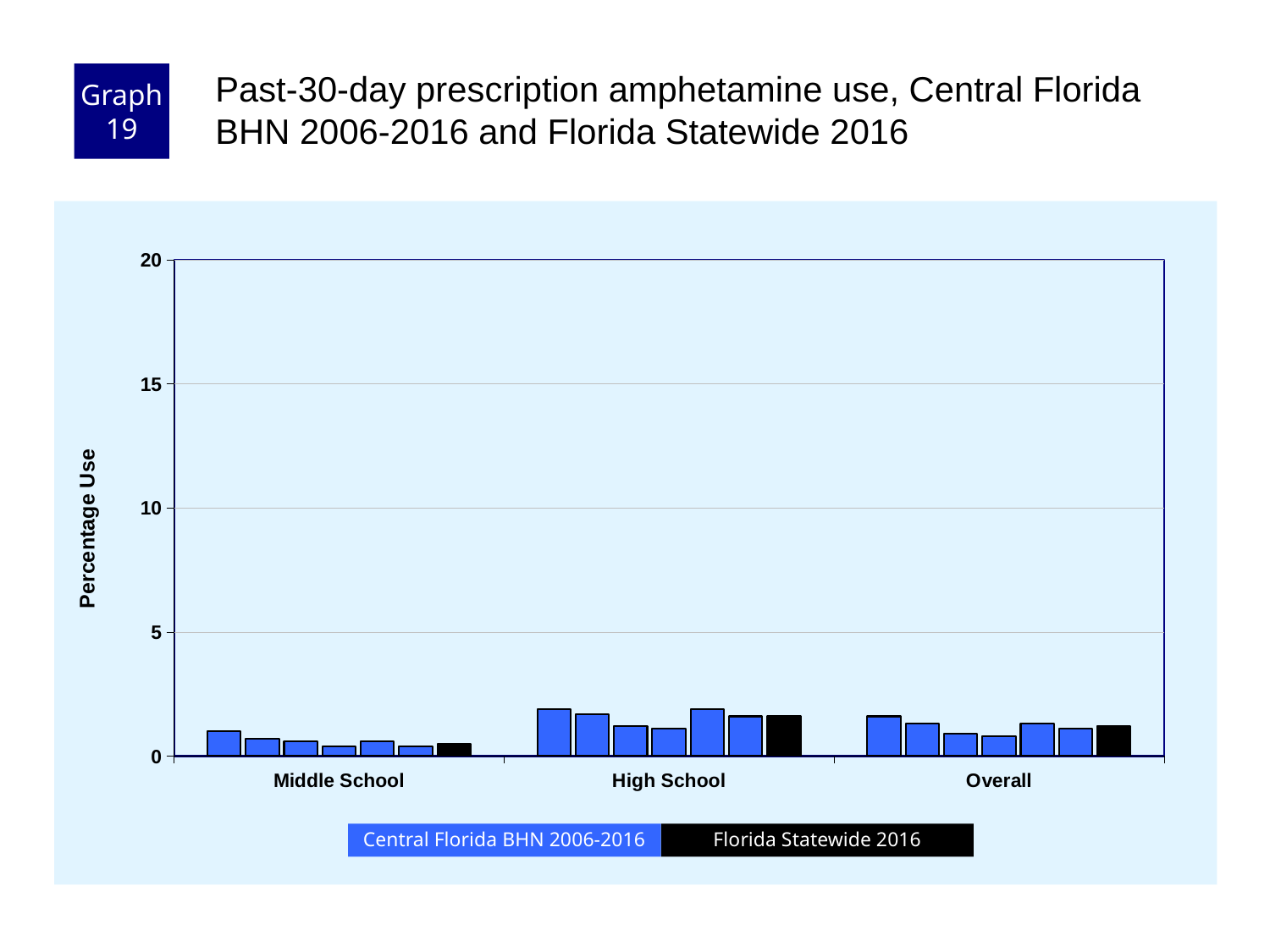
Is the Florida Statewide 2016 value larger for High School or for Middle School? High School Which category has the highest Florida Statewide 2016 value? High School How many categories are shown on the x axis of the chart? 3 Which series is shown in black in the chart? Florida Statewide 2016 Which category has the lowest Florida Statewide 2016 value? Middle School What is the label of the y axis? Percentage Use What kind of chart is shown on the slide? bar chart Is the Florida Statewide 2016 value for High School greater or less than 5? less Are all the bars in the chart below the 5 tick on the y axis? Yes How many series does the chart's legend list? 2 Is the Florida Statewide 2016 value for Overall greater or less than 5? less